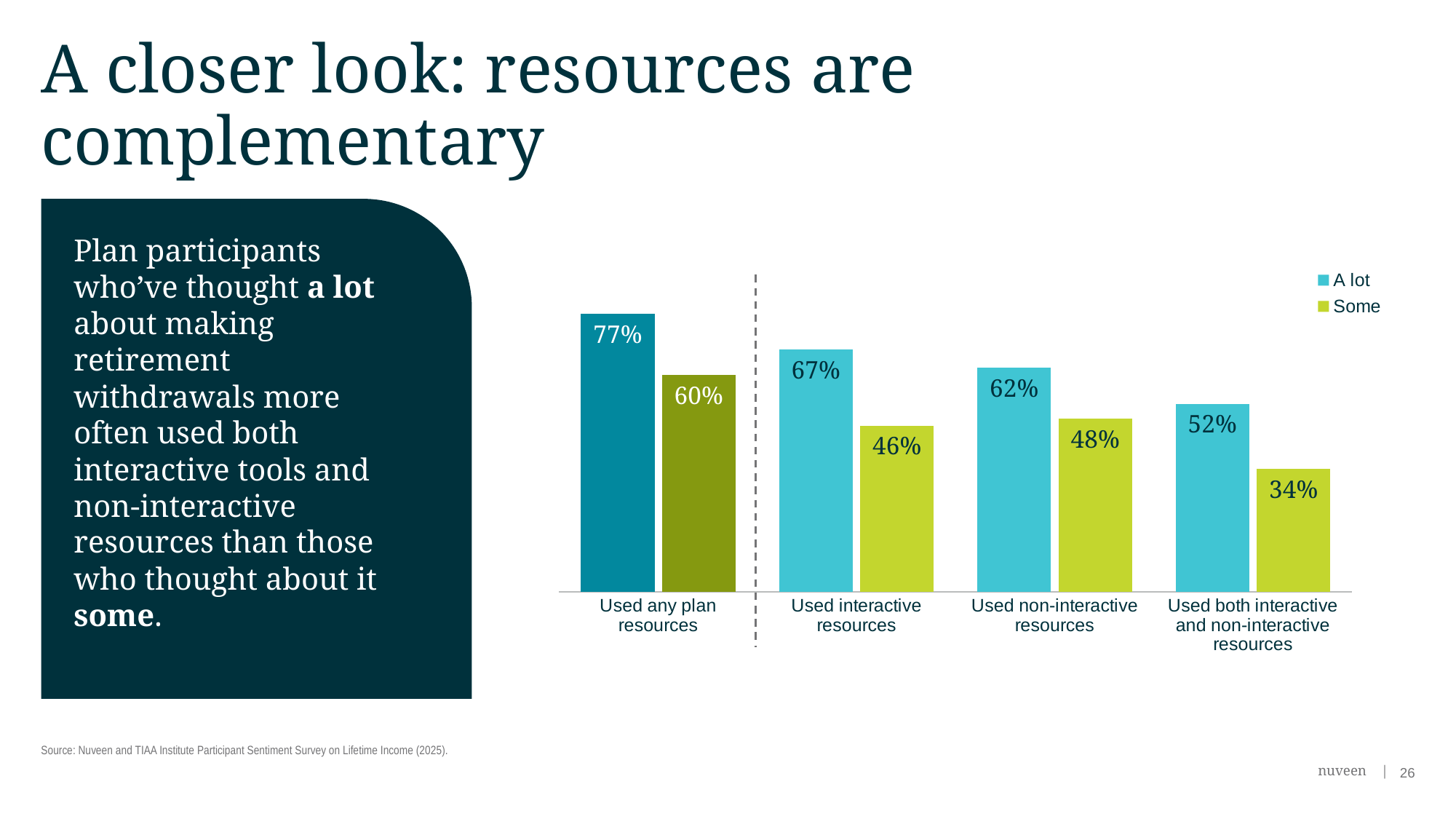
What is the difference between the "A lot" and "Some" values for "Used both interactive and non-interactive resources"? 18 percentage points What is the value for "Some" in the "Used both interactive and non-interactive resources" category? 34% Which category has the lowest value for the "Some" series? Used both interactive and non-interactive resources How many categories are shown on the x axis of the chart? 4 How many series does the legend list? 2 What is the difference between the "A lot" and "Some" values for "Used interactive resources"? 21 percentage points Which category has the highest value for the "A lot" series? Used any plan resources What are the two series names listed in the legend? A lot and Some What kind of chart is shown on the slide? Bar chart What is the value for "A lot" in the "Used any plan resources" category? 77% Which is larger: the "Some" value for "Used interactive resources" or the "Some" value for "Used non-interactive resources"? Used non-interactive resources What is the value for "Some" in the "Used non-interactive resources" category? 48%